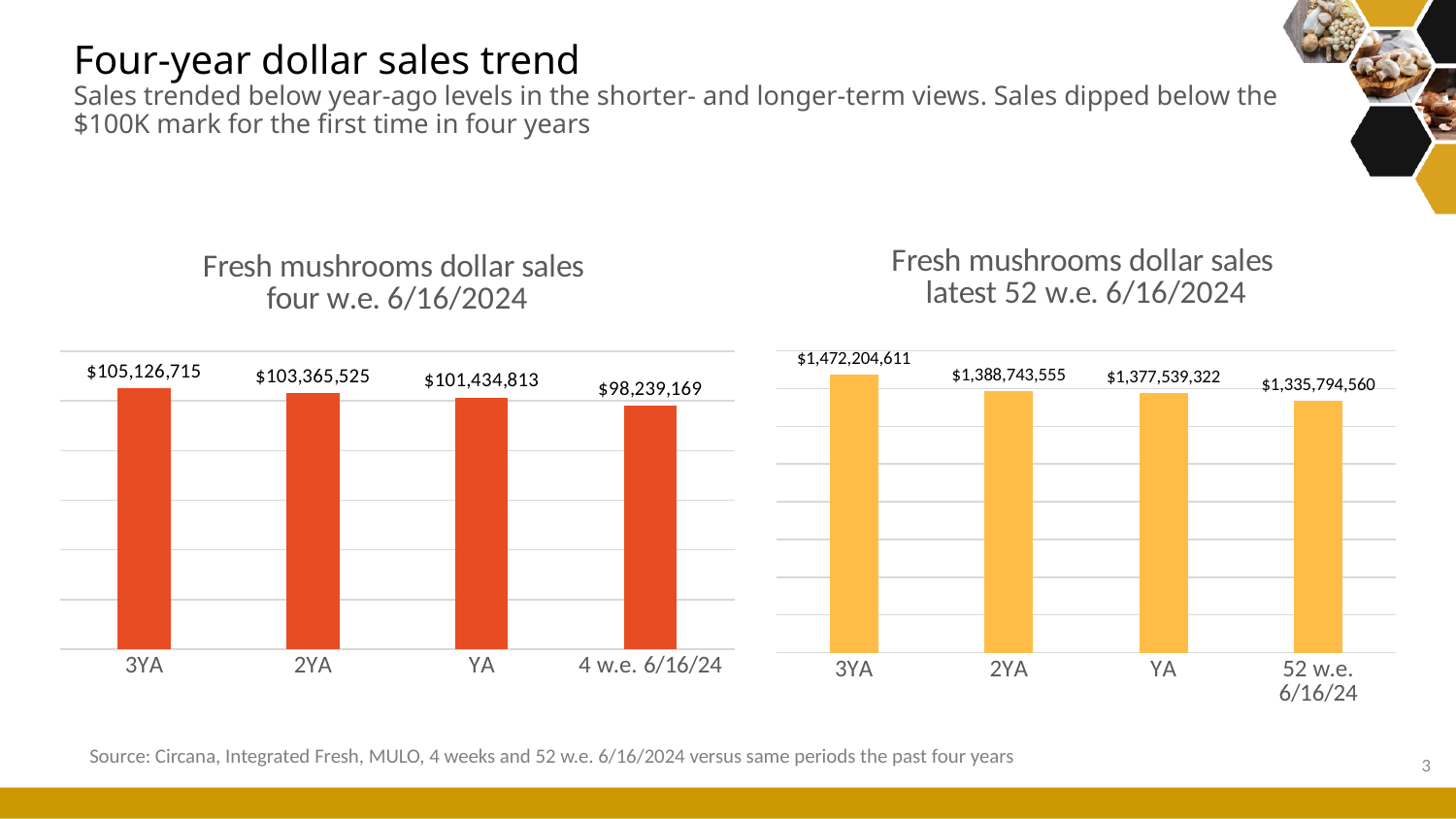
In the 'Fresh mushrooms dollar sales latest 52 w.e. 6/16/2024' chart, what is the value for 2YA? $1,388,743,555 In the 'Fresh mushrooms dollar sales four w.e. 6/16/2024' chart, which category has the highest value? 3YA In the 'Fresh mushrooms dollar sales latest 52 w.e. 6/16/2024' chart, what is the value for 52 w.e. 6/16/24? $1,335,794,560 In the 'Fresh mushrooms dollar sales four w.e. 6/16/2024' chart, which is larger, the value for 2YA or the value for YA? 2YA What kind of chart is the 'Fresh mushrooms dollar sales four w.e. 6/16/2024' chart? Bar chart In the 'Fresh mushrooms dollar sales four w.e. 6/16/2024' chart, what is the value for 4 w.e. 6/16/24? $98,239,169 In the 'Fresh mushrooms dollar sales latest 52 w.e. 6/16/2024' chart, which category has the lowest value? 52 w.e. 6/16/24 In the 'Fresh mushrooms dollar sales four w.e. 6/16/2024' chart, what is the difference between the 3YA value and the 4 w.e. 6/16/24 value? $6,887,546 In the 'Fresh mushrooms dollar sales four w.e. 6/16/2024' chart, what is the value for 3YA? $105,126,715 How many categories are shown in the 'Fresh mushrooms dollar sales latest 52 w.e. 6/16/2024' chart? 4 In the 'Fresh mushrooms dollar sales latest 52 w.e. 6/16/2024' chart, do the values rise or fall from 3YA to 52 w.e. 6/16/24? Fall In the 'Fresh mushrooms dollar sales latest 52 w.e. 6/16/2024' chart, what is the difference between the 3YA value and the 2YA value? $83,461,056